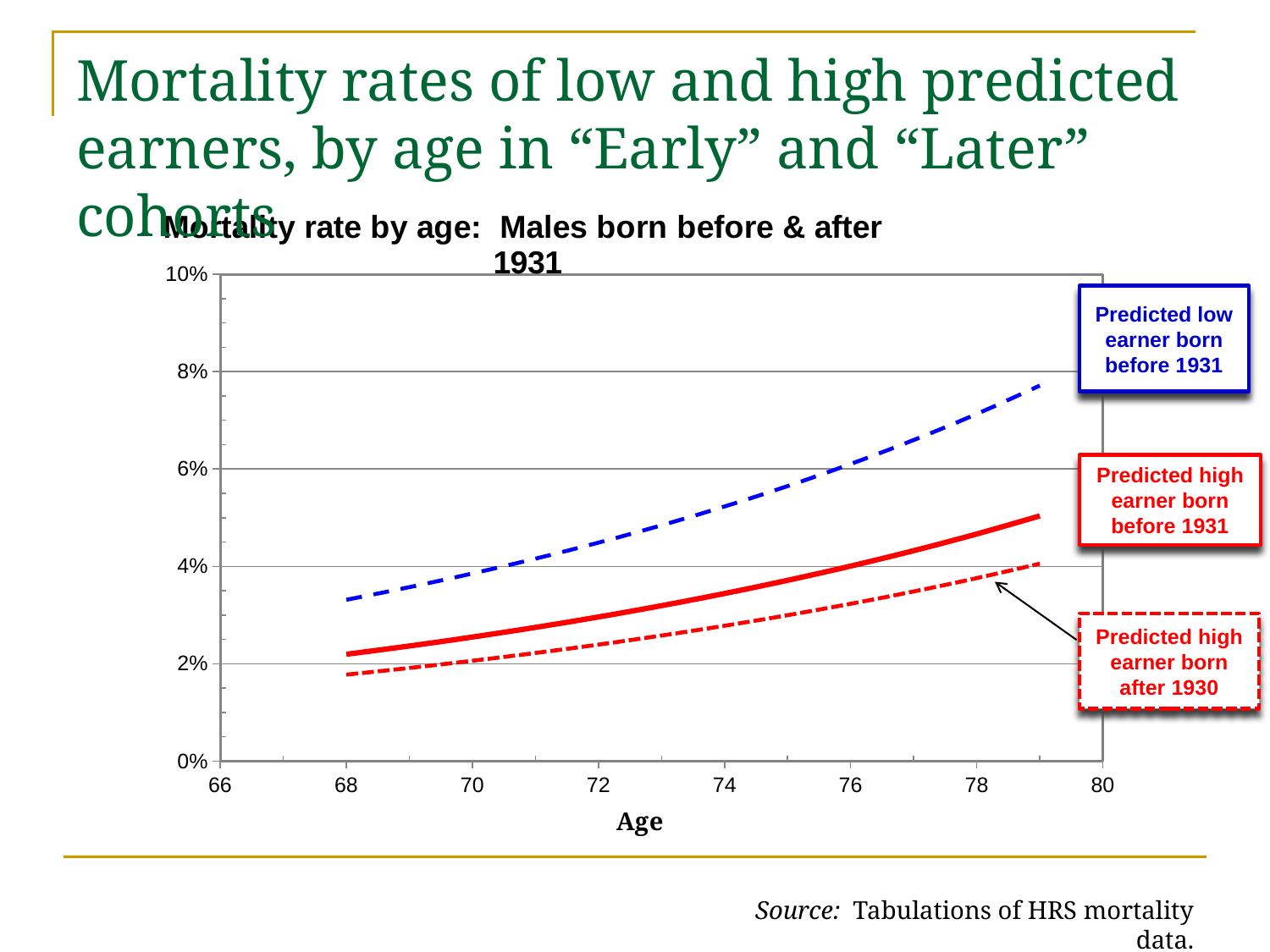
How many series are plotted on the chart? 3 Does the mortality rate for predicted high earners born after 1930 rise or fall as age increases? rise At age 68, is the mortality rate for predicted low earners born before 1931 greater or less than 2%? greater At age 79, is the mortality rate for predicted low earners born before 1931 greater or less than 6%? greater At age 79, which is larger: the mortality rate for predicted low earners born before 1931 or for predicted high earners born before 1931? Predicted low earner born before 1931 Which series has the lowest mortality rate at age 79? Predicted high earner born after 1930 What kind of chart is shown on the slide? line chart Does the mortality rate for predicted low earners born before 1931 rise or fall as age increases? rise What is the label on the x axis of the chart? Age Which series has the highest mortality rate at age 79? Predicted low earner born before 1931 At age 74, is the mortality rate for predicted high earners born after 1930 greater or less than 4%? less